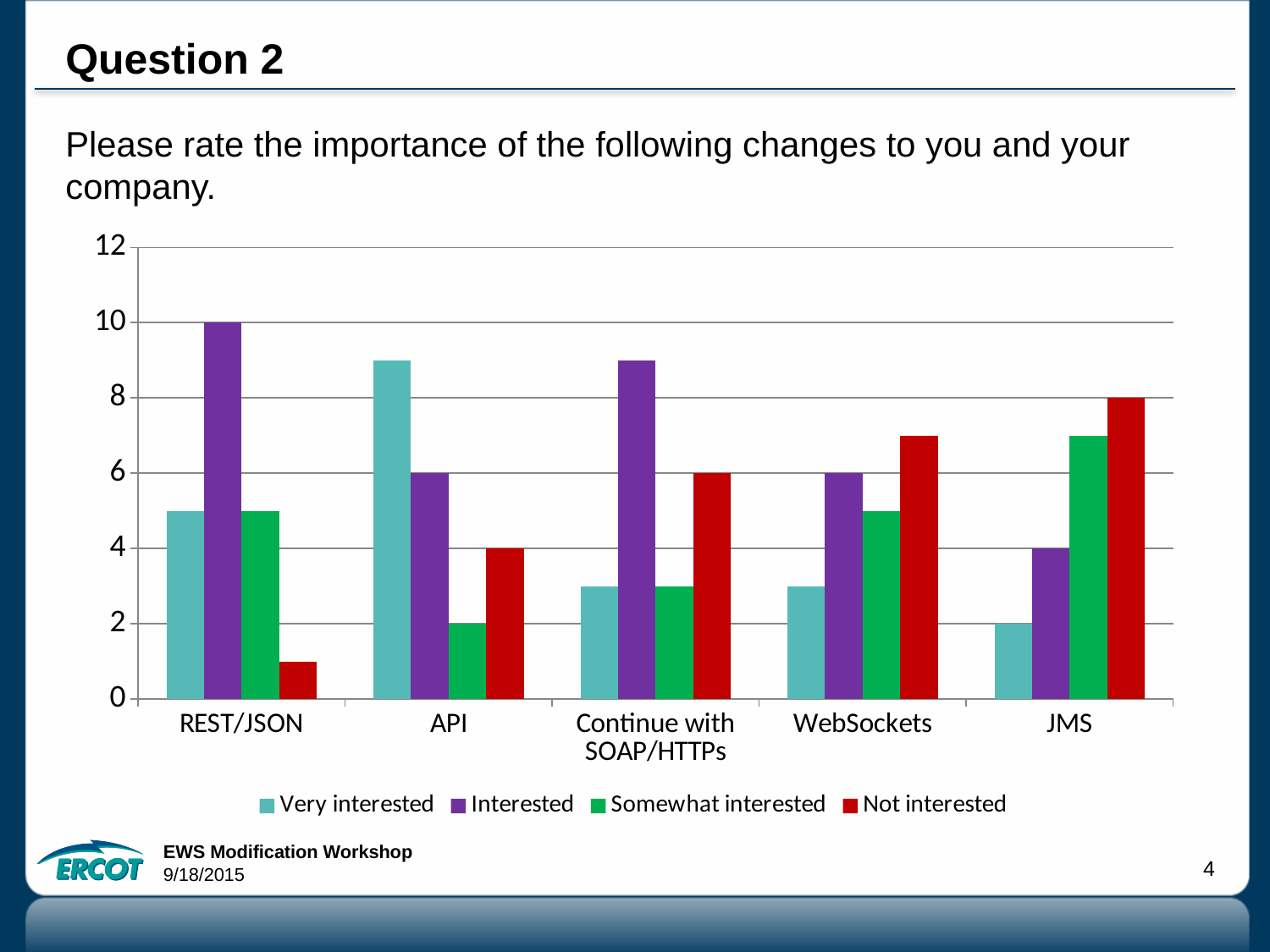
What is the value of the Interested series for REST/JSON? 10 For JMS, which series has the highest value? Not interested Which category has the tallest bar in the whole chart? REST/JSON What type of chart is shown on the slide? bar chart What is the value of the Interested series for API? 6 Is the Not interested value for REST/JSON greater or less than 2? less Is the Very interested value for API greater or less than 8? greater For API, which is larger: the Very interested value or the Interested value? Very interested How many series does the chart's legend list? 4 What is the value of the Not interested series for JMS? 8 What is the difference between the Not interested value and the Very interested value for JMS? 6 How many categories are shown on the x axis of the chart? 5